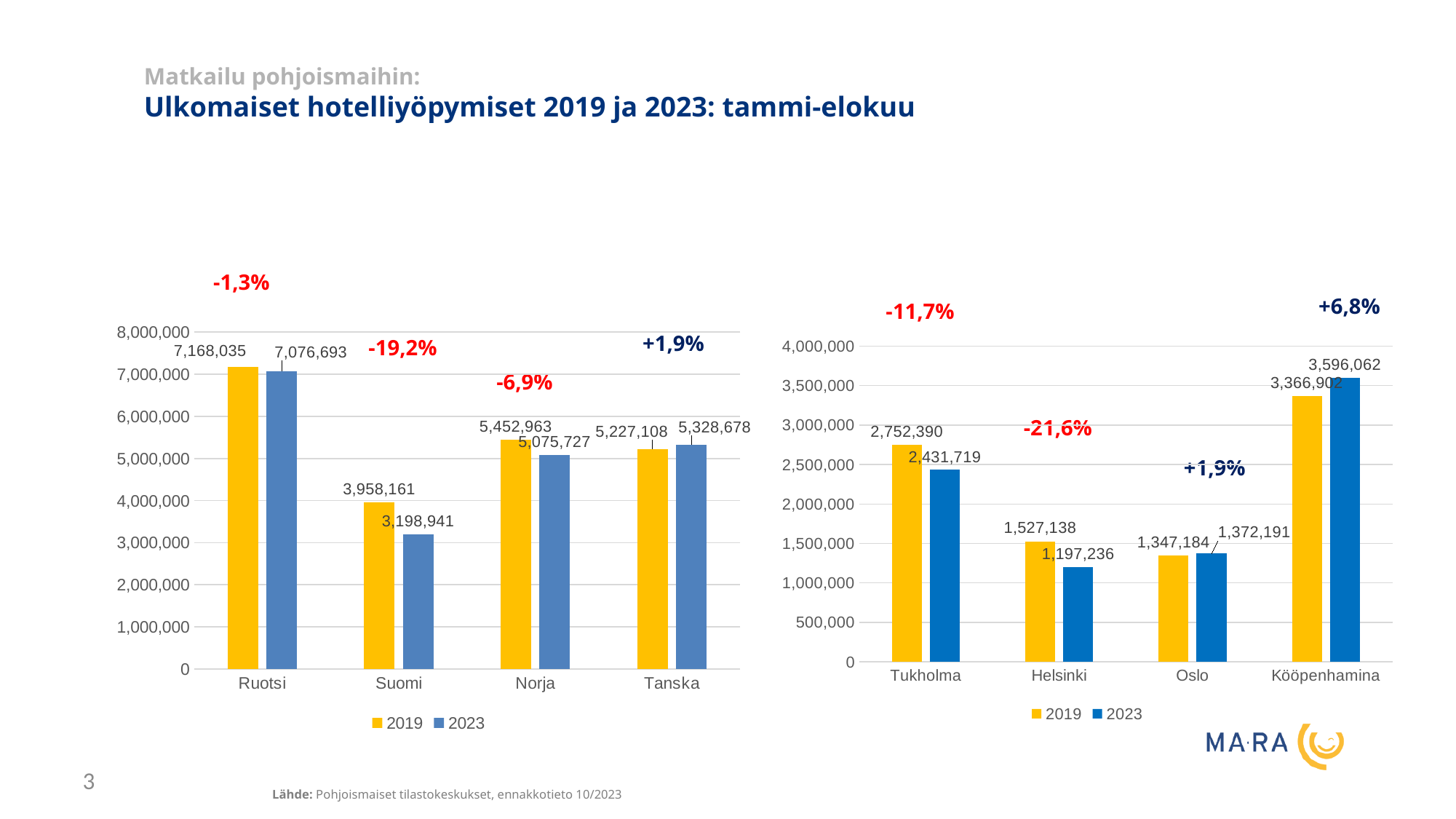
In the left chart, what is the 2023 value for Tanska? 5,328,678 In the right chart, what is the 2023 value for Helsinki? 1,197,236 In the left chart, which is larger for Norja: the 2019 value or the 2023 value? 2019 In the right chart, which city has the lowest 2023 value? Helsinki How many cities are shown in the right chart? 4 In the right chart, what is the difference between the 2023 and 2019 values for Kööpenhamina? 229,160 In the right chart, what is the 2019 value for Kööpenhamina? 3,366,902 In the left chart, which country has the highest 2019 value? Ruotsi In the left chart, what is the 2019 value for Suomi? 3,958,161 What type of chart is the right chart? Bar chart How many series does the legend of the left chart list? 2 In the left chart, what is the difference between the 2019 and 2023 values for Suomi? 759,220